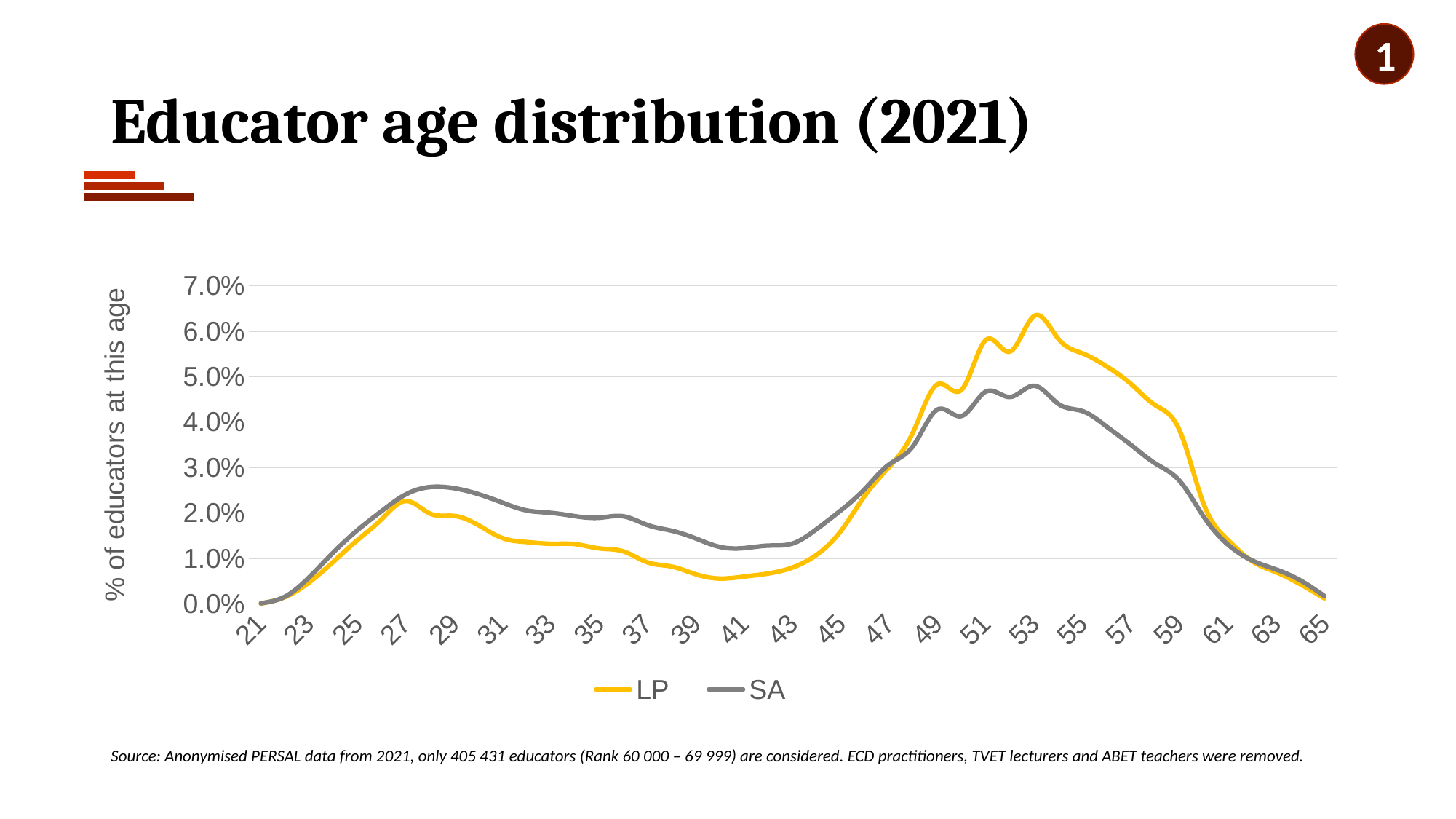
How many series does the legend list? 2 What kind of chart is shown on the slide? line chart Is the value for SA at age 53 greater or less than 4.0%? greater Is the value for LP at age 53 greater or less than 6.0%? greater What are the two series named in the legend? LP and SA Is the value for SA at age 41 greater or less than 2.0%? less Between ages 53 and 65, does the LP series rise or fall? fall At age 29, which series has the higher value, LP or SA? SA What is the title of the vertical axis? % of educators at this age At age 53, which series has the higher value, LP or SA? LP At which age does the LP series reach its highest value? 53